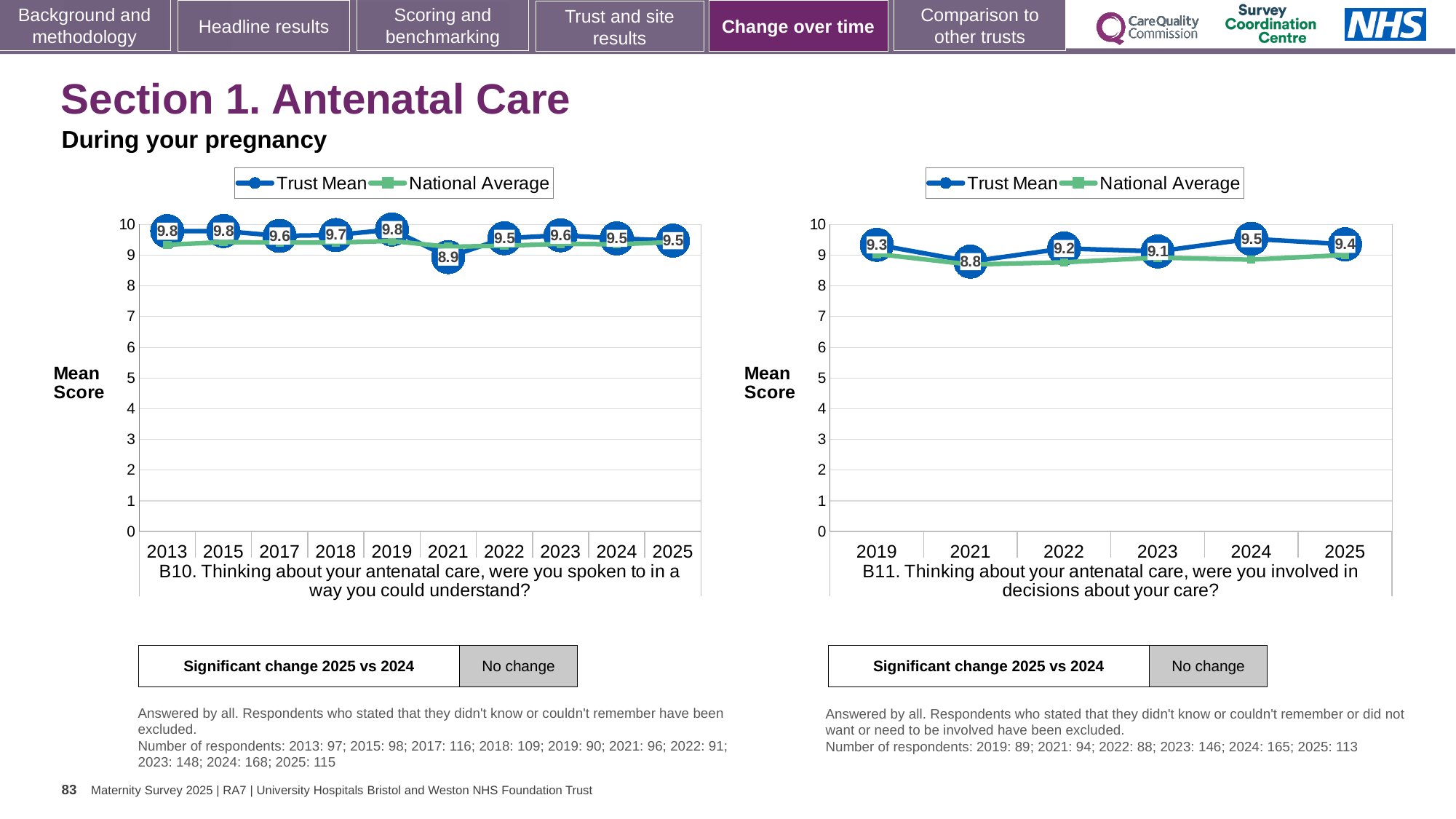
In the B11 chart (right), which year has the highest Trust Mean? 2024 In the B10 chart (left), how many years are shown on the x axis? 10 In the B10 chart (left), which year has the lowest Trust Mean? 2021 In the B11 chart (right), what is the Trust Mean for 2021? 8.8 In the B11 chart (right), is the Trust Mean for 2021 greater or less than 9? less In the B11 chart (right), is the Trust Mean for 2022 larger or smaller than for 2023? larger In the B10 chart (left), what is the difference between the Trust Mean for 2019 and 2021? 0.9 In the B11 chart (right), what is the Trust Mean for 2024? 9.5 In the B10 chart (left), what is the Trust Mean for 2021? 8.9 In the B10 chart (left), what is the Trust Mean for 2025? 9.5 What type of chart is the B10 chart (left)? Line chart In the B11 chart (right), how many series does the legend list? 2